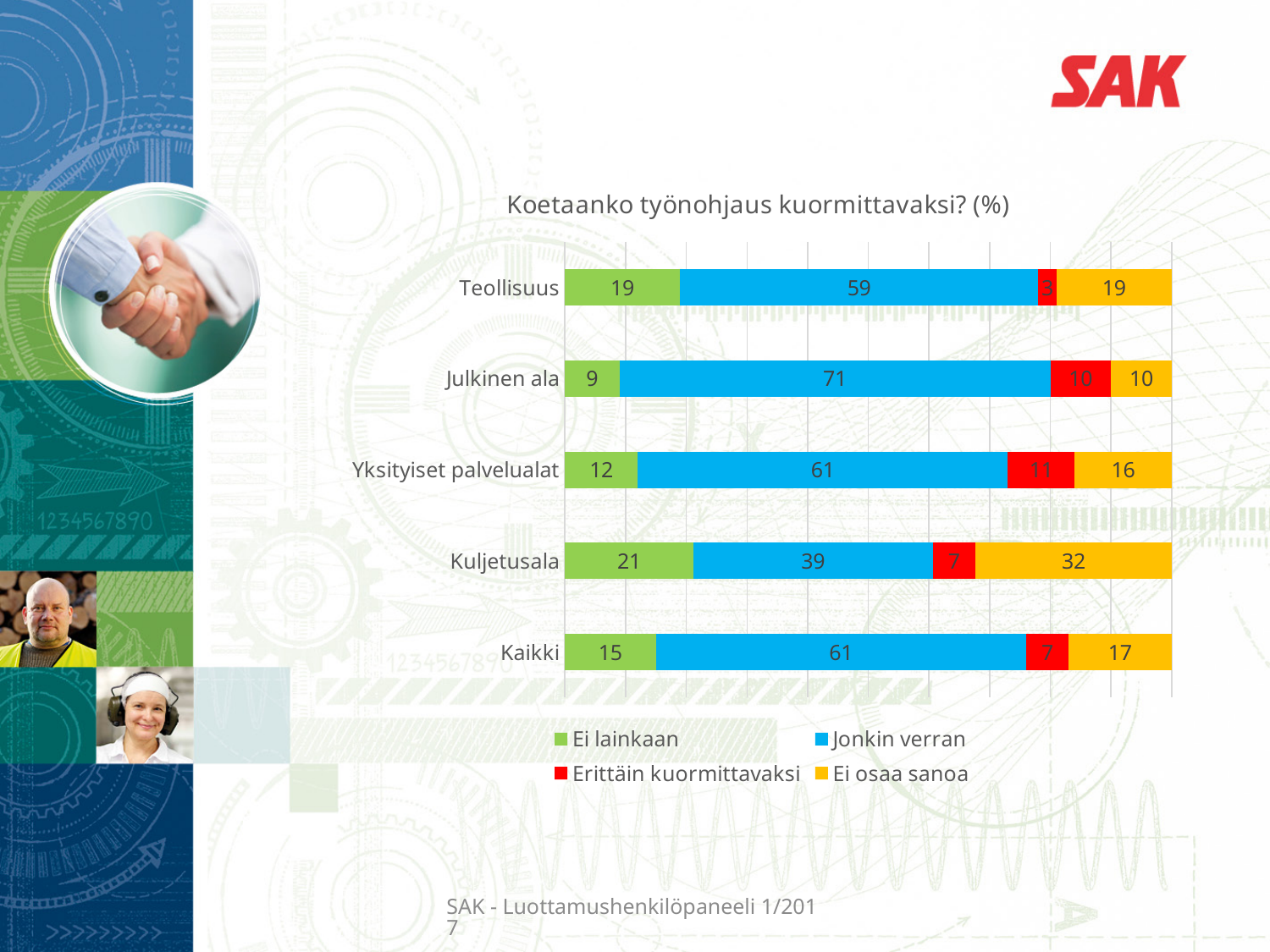
What is the title of the chart? Koetaanko työnohjaus kuormittavaksi? (%) What is the total of the stacked bar for Kuljetusala? 99 Which category has the lowest 'Jonkin verran' value? Kuljetusala What is the 'Erittäin kuormittavaksi' value for Teollisuus? 3 How many series does the legend list? 4 Which is larger, the 'Ei osaa sanoa' value for Yksityiset palvelualat or for Kaikki? Kaikki What is the 'Jonkin verran' value for Julkinen ala? 71 What is the 'Ei osaa sanoa' value for Kuljetusala? 32 How many categories are shown on the chart? 5 What kind of chart is shown on the slide? Stacked bar chart What is the difference between the 'Jonkin verran' values for Julkinen ala and Kuljetusala? 32 Which category has the highest 'Ei lainkaan' value? Kuljetusala